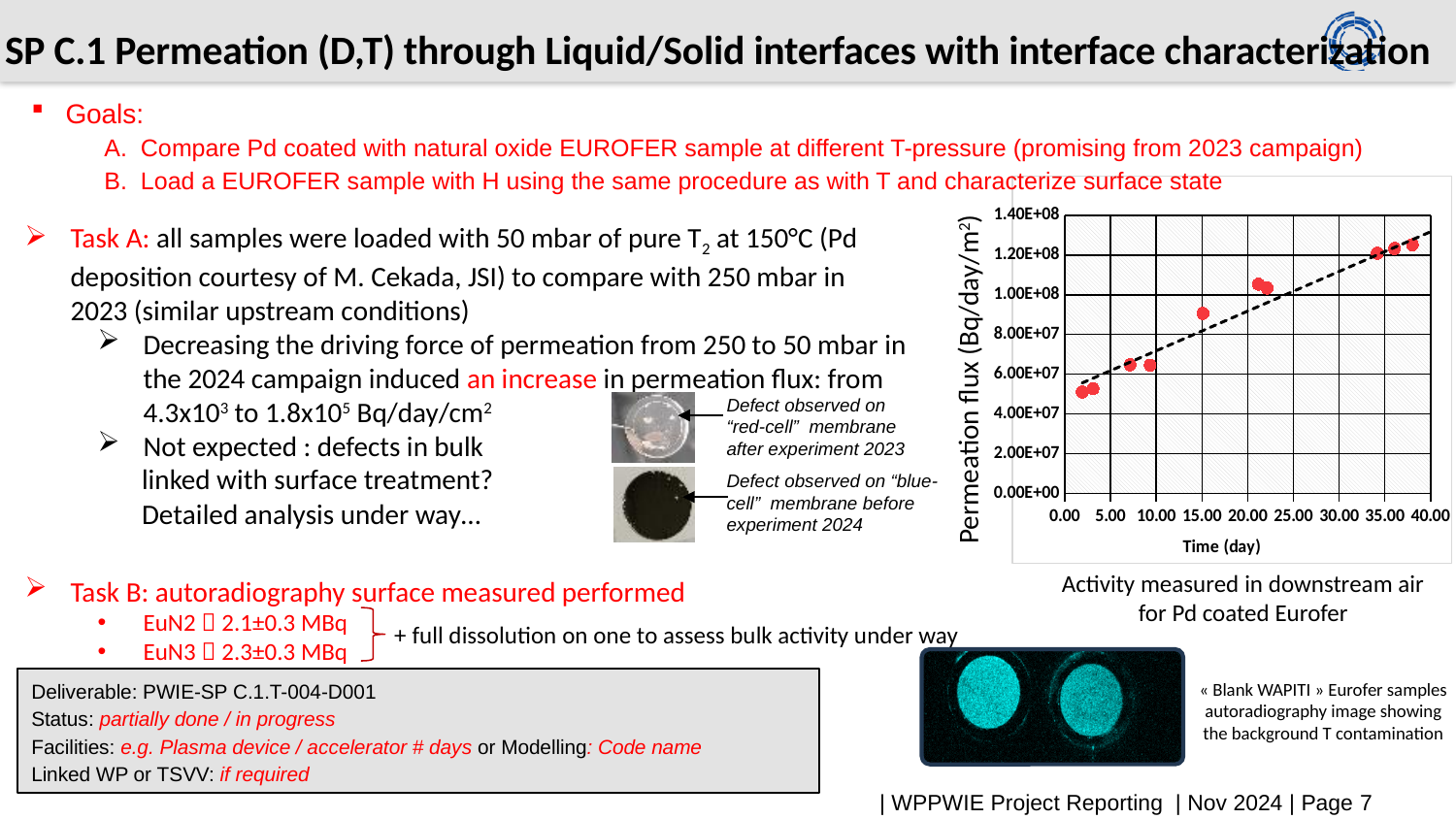
What is the label of the x axis of the chart? Time (day) Is the permeation flux measured around day 2 greater or less than 6.00E+07? less Does the permeation flux rise or fall as time increases along the x axis? rise Is the permeation flux measured around day 35 greater or less than 1.00E+08? greater What is the highest value shown on the y axis of the chart? 1.40E+08 Which is larger, the permeation flux measured around day 2 or the one measured around day 15? around day 15 What kind of chart is shown on the right of the slide? scatter chart Is the permeation flux measured around day 8 greater or less than 8.00E+07? less Which is larger, the permeation flux measured around day 22 or the one measured around day 8? around day 22 What is the label of the y axis of the chart? Permeation flux (Bq/day/m2)